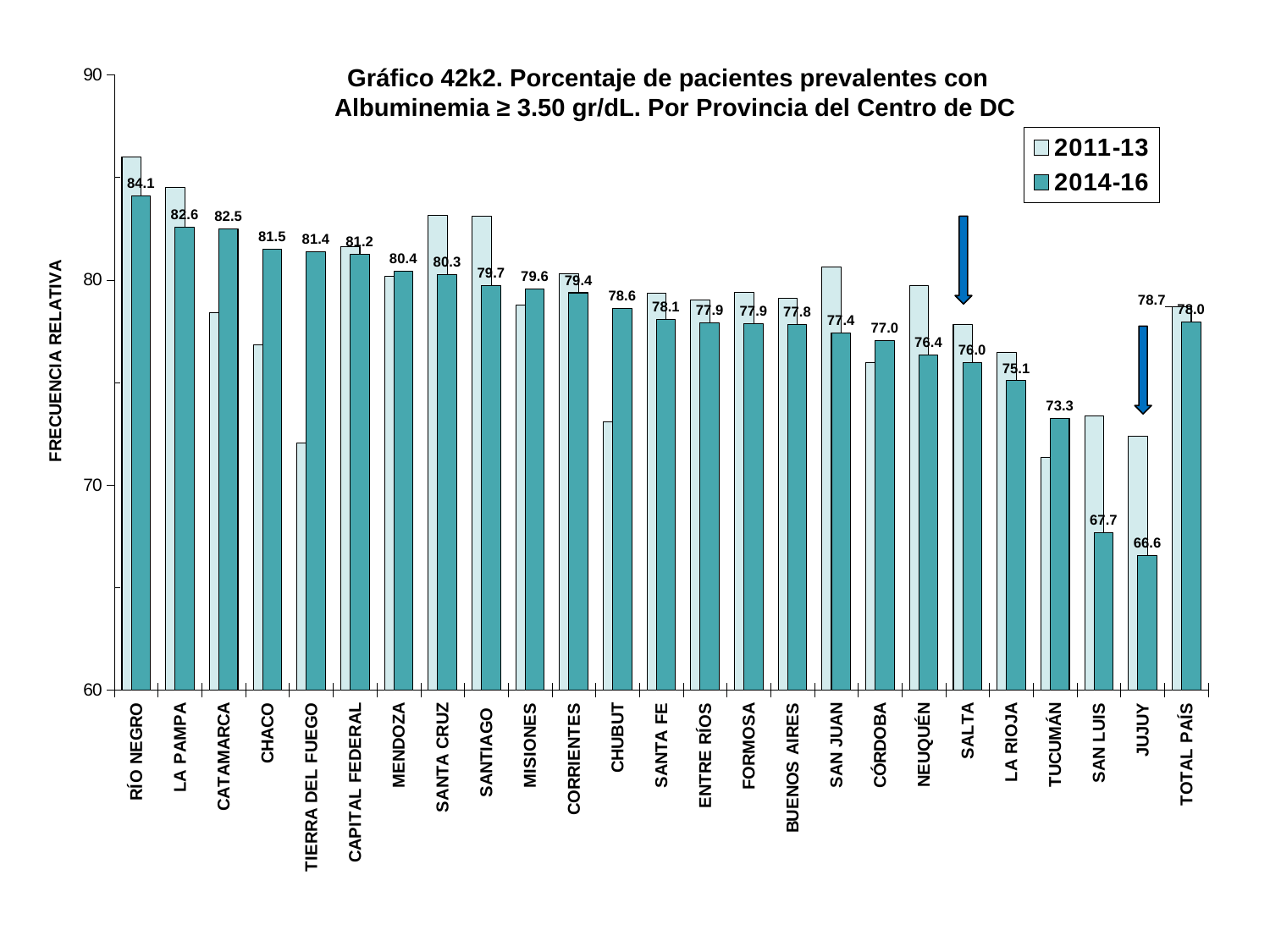
Which province has the lowest 2014-16 value? Jujuy How many series does the legend list? 2 How many categories are shown on the x axis? 25 What is the 2014-16 value for Tucumán? 73.3 Is the 2011-13 value for Río Negro greater or less than 80? greater Is the 2011-13 value for Tierra del Fuego greater or less than 80? less What kind of chart is shown on the slide? Bar chart What is the 2014-16 value for Total País? 78.0 What is the difference between the 2014-16 values for Río Negro and Jujuy? 17.5 What is the 2014-16 value for Río Negro? 84.1 Which province has the highest 2014-16 value? Río Negro Which has the larger 2014-16 value, Catamarca or Chaco? Catamarca